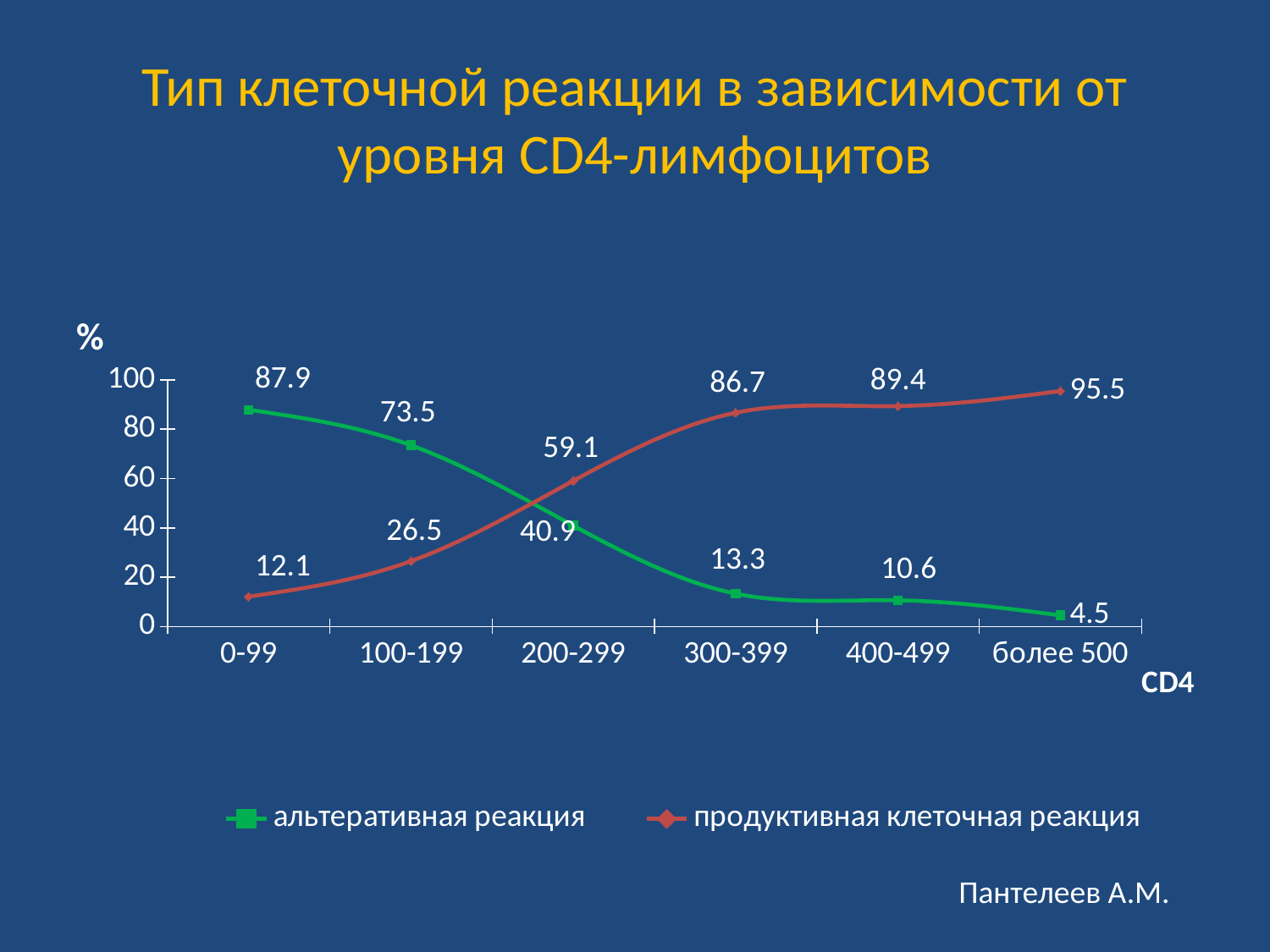
At which CD4 level is альтеративная реакция lowest? более 500 What is the value for альтеративная реакция at CD4 level более 500? 4.5 What kind of chart is shown on the slide? line chart What is the value for альтеративная реакция at CD4 level 0-99? 87.9 At which CD4 level is продуктивная клеточная реакция highest? более 500 How many series does the legend list? 2 What is the difference between продуктивная клеточная реакция and альтеративная реакция at CD4 level 300-399? 73.4 At CD4 level 100-199, which series has the larger value: альтеративная реакция or продуктивная клеточная реакция? альтеративная реакция How many CD4 level categories are shown on the x axis? 6 What is the value for продуктивная клеточная реакция at CD4 level 200-299? 59.1 What is the title of the chart on the slide? Тип клеточной реакции в зависимости от уровня CD4-лимфоцитов Does the value for альтеративная реакция rise or fall as the CD4 level increases along the x axis? fall